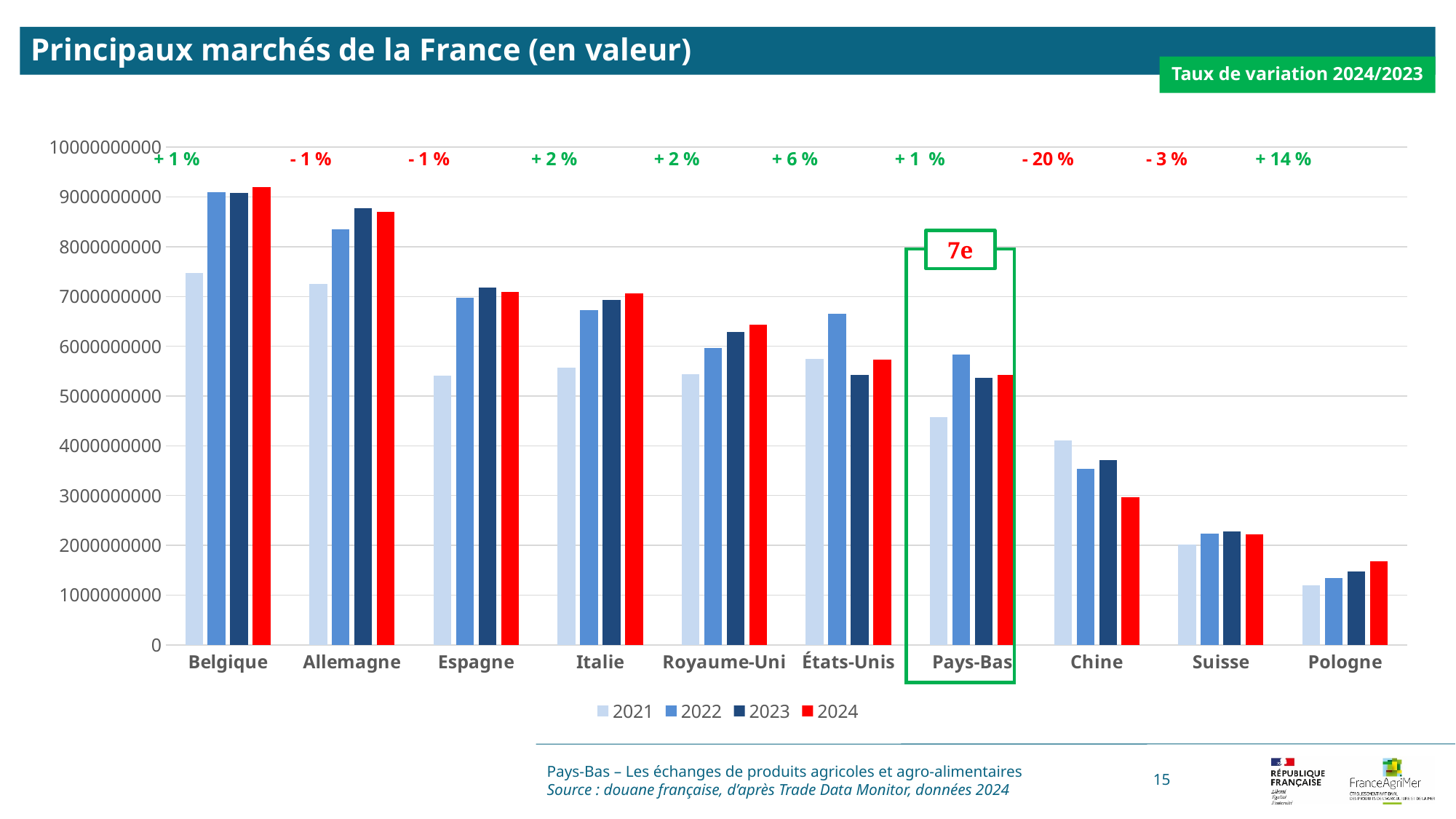
How many series does the chart legend list? 4 Is the 2024 value for Belgique greater or less than 9000000000? greater Which country has the lowest 2024 value in the chart? Pologne What is the 2024/2023 variation rate printed above Pologne? + 14 % Is the 2021 value for Pologne greater or less than 2000000000? less What is the 2024/2023 variation rate printed above États-Unis? + 6 % Which is larger, the 2024 value for Belgique or the 2024 value for Allemagne? Belgique What kind of chart is shown on the slide? bar chart What is the 2024/2023 variation rate printed above Chine? - 20 % What rank label is shown in the green box above Pays-Bas? 7e Which country has the highest 2024 value in the chart? Belgique How many countries are shown on the x axis of the chart? 10